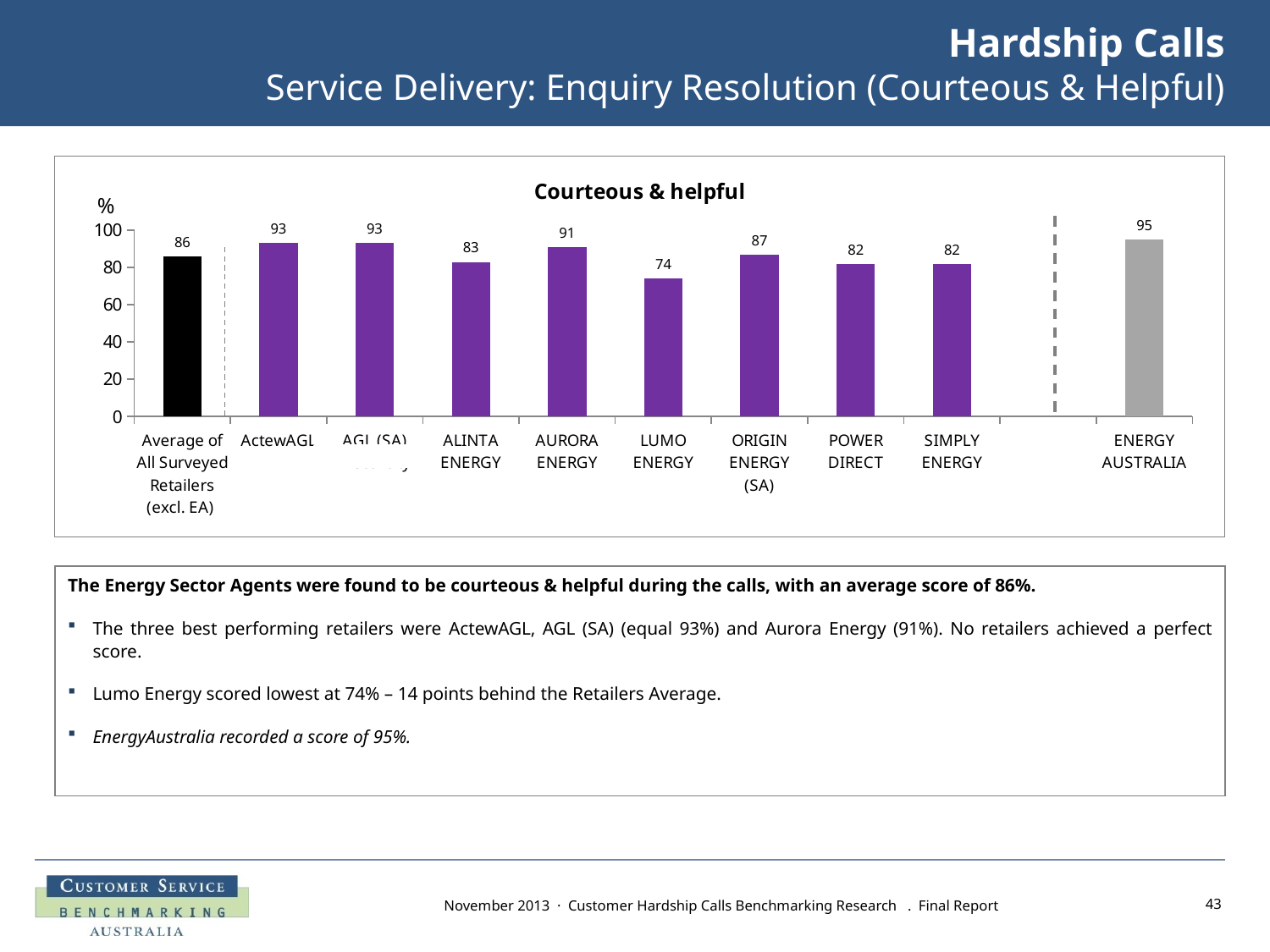
Is the value for Simply Energy in the Courteous & helpful chart greater or less than 60? greater What is the value for the Average of All Surveyed Retailers (excl. EA) in the Courteous & helpful chart? 86 Which has a higher value in the Courteous & helpful chart, Origin Energy (SA) or Power Direct? Origin Energy (SA) What is the value for Lumo Energy in the Courteous & helpful chart? 74 What is the difference between the values for Aurora Energy and Alinta Energy in the Courteous & helpful chart? 8 Which category has the lowest value in the Courteous & helpful chart? Lumo Energy How many bars are plotted in the Courteous & helpful chart? 10 What is the value for Energy Australia in the Courteous & helpful chart? 95 What kind of chart is the Courteous & helpful chart? Bar chart Which category has the highest value in the Courteous & helpful chart? Energy Australia What is the value for Origin Energy (SA) in the Courteous & helpful chart? 87 What is the difference between the Average of All Surveyed Retailers (excl. EA) and Lumo Energy in the Courteous & helpful chart? 14